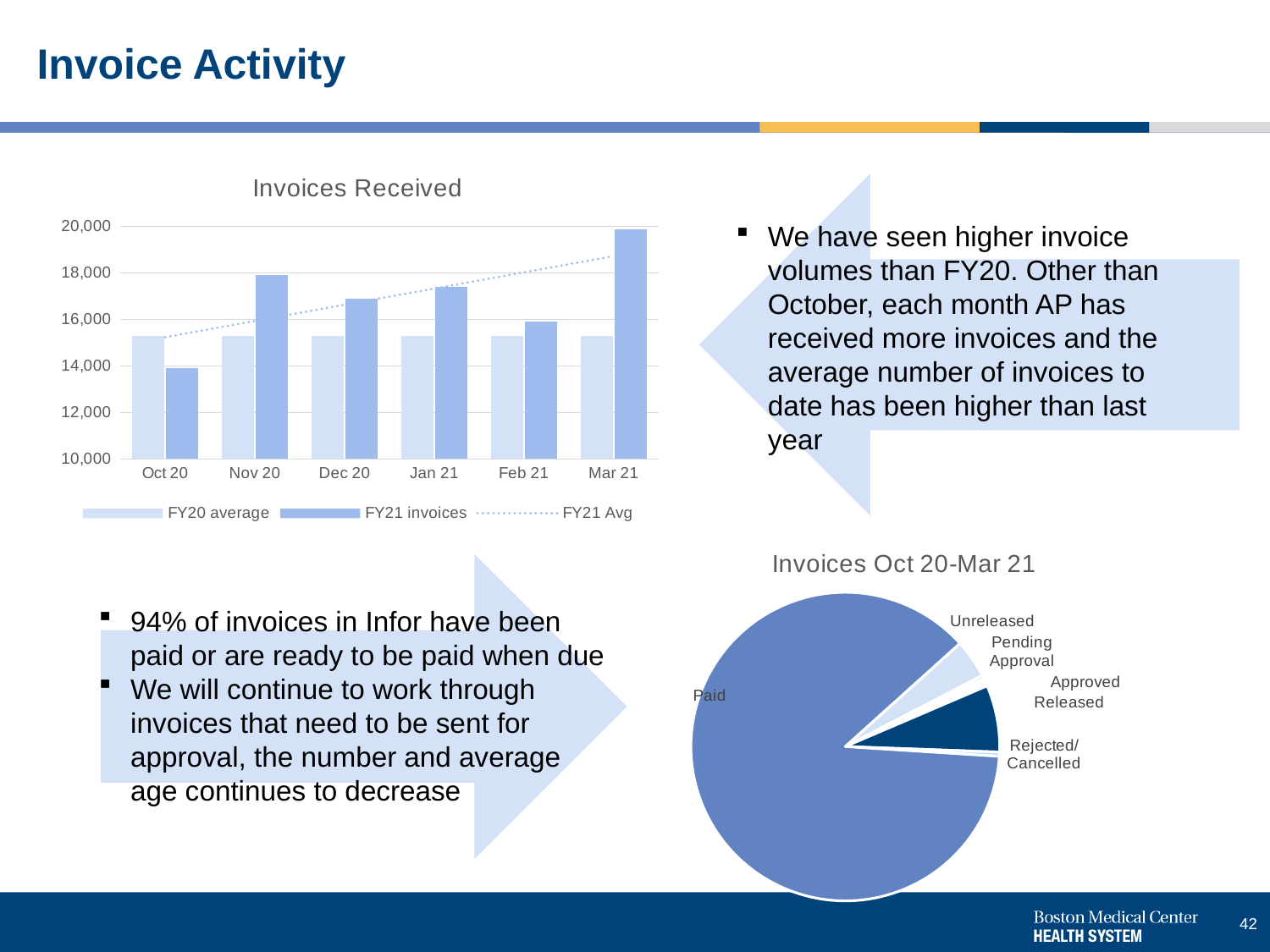
On the Invoices Received chart, how many series does the legend list? 3 On the Invoices Received chart, is the FY21 invoices value for Mar 21 greater or less than 18,000? greater On the Invoices Received chart, which is larger for Nov 20: the FY20 average or the FY21 invoices? FY21 invoices On the Invoices Received chart, is the FY21 invoices value for Oct 20 greater or less than 16,000? less On the Invoices Received chart, which month has the highest FY21 invoices value? Mar 21 On the Invoices Received chart, how many months are shown on the x axis? 6 On the Invoices Received chart, what kind of chart is used to show the FY20 average and FY21 invoices? Bar chart On the Invoices Received chart, does the dotted FY21 Avg line rise or fall from Oct 20 to Mar 21? Rises On the Invoices Received chart, which is larger for Oct 20: the FY20 average or the FY21 invoices? FY20 average On the Invoices Oct 20-Mar 21 pie chart, which slice is the largest? Paid On the Invoices Received chart, which month has the lowest FY21 invoices value? Oct 20 On the Invoices Oct 20-Mar 21 pie chart, how many slices are labelled? 6